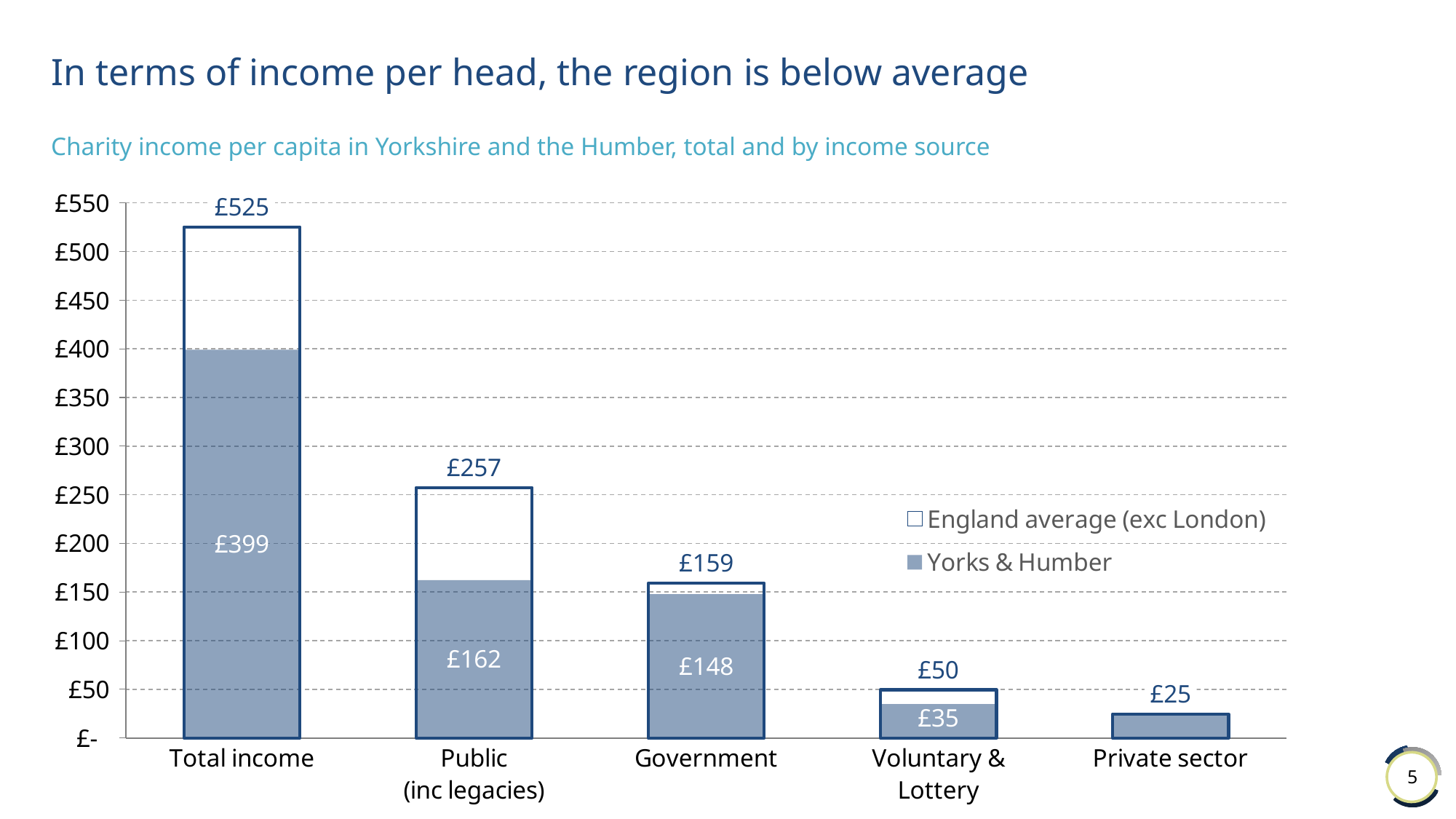
What is the England average (exc London) value for Government? £159 What is the England average (exc London) value for Total income? £525 Which income source category has the lowest England average (exc London) value? Private sector What is the Yorks & Humber value for Total income? £399 How many categories are shown on the x axis? 5 What kind of chart is shown on the slide? Bar chart How many series does the legend list? 2 What is the Yorks & Humber value for Public (inc legacies)? £162 What is the difference between the England average (exc London) and Yorks & Humber values for Public (inc legacies)? £95 What is the difference between the England average (exc London) and Yorks & Humber values for Total income? £126 Which is larger for Government: the England average (exc London) or Yorks & Humber? England average (exc London) What is the Yorks & Humber value for Voluntary & Lottery? £35